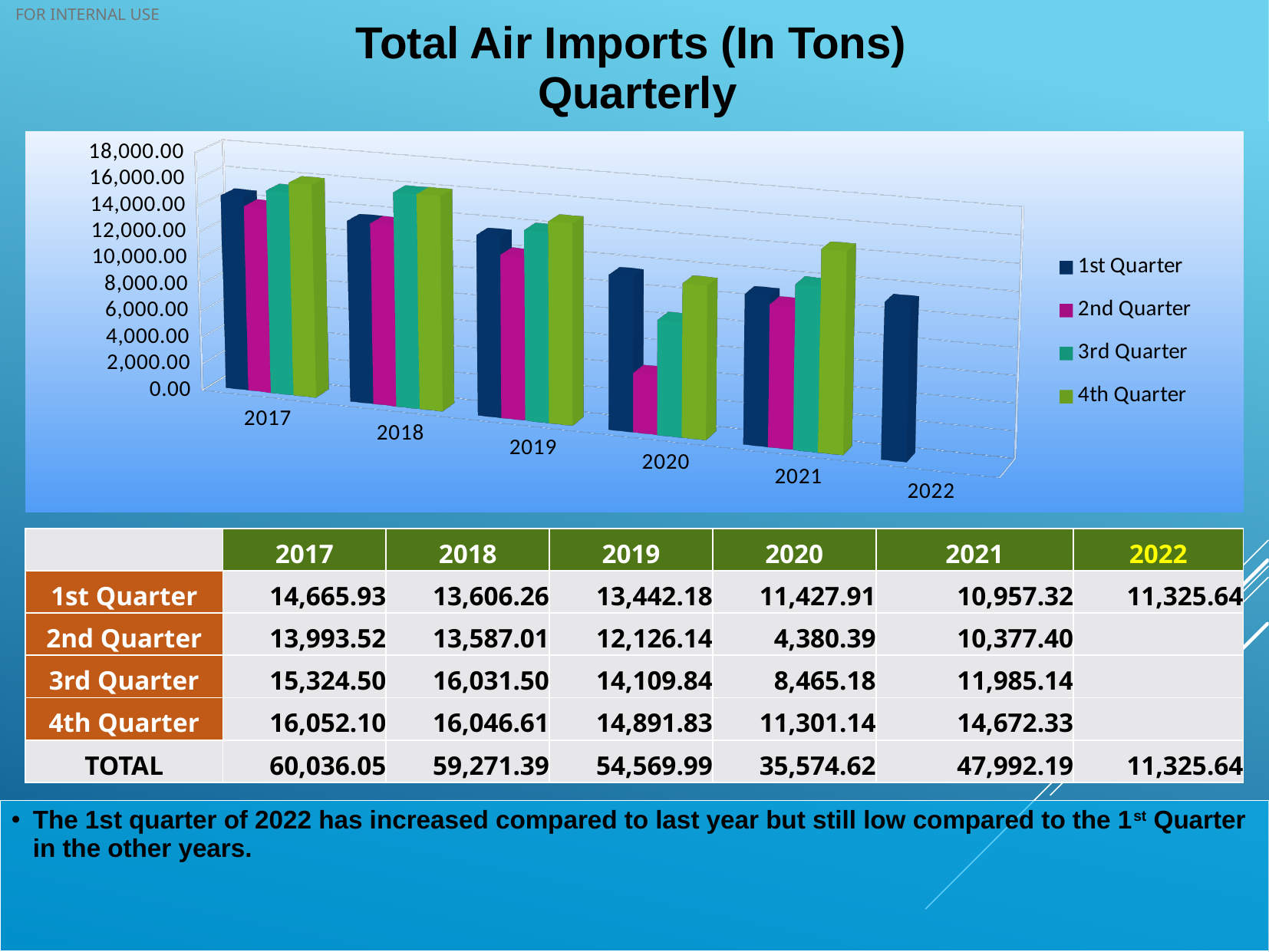
How many series does the legend list? 4 What kind of chart is shown on the slide? bar chart Which quarter has the lowest value in 2020? 2nd Quarter In 2021, which is larger: the 3rd Quarter value or the 4th Quarter value? 4th Quarter What is the difference between the 3rd Quarter values for 2018 and 2019? 1,921.66 Do the 1st Quarter values rise or fall from 2017 to 2021? fall How many years are shown on the x axis of the chart? 6 Is the 2nd Quarter value for 2020 greater or less than 6,000.00? less In which year is the 2nd Quarter value the lowest? 2020 What is the 2nd Quarter value for 2020? 4,380.39 What is the 1st Quarter value for 2017? 14,665.93 What colour represents the 4th Quarter in the legend? green